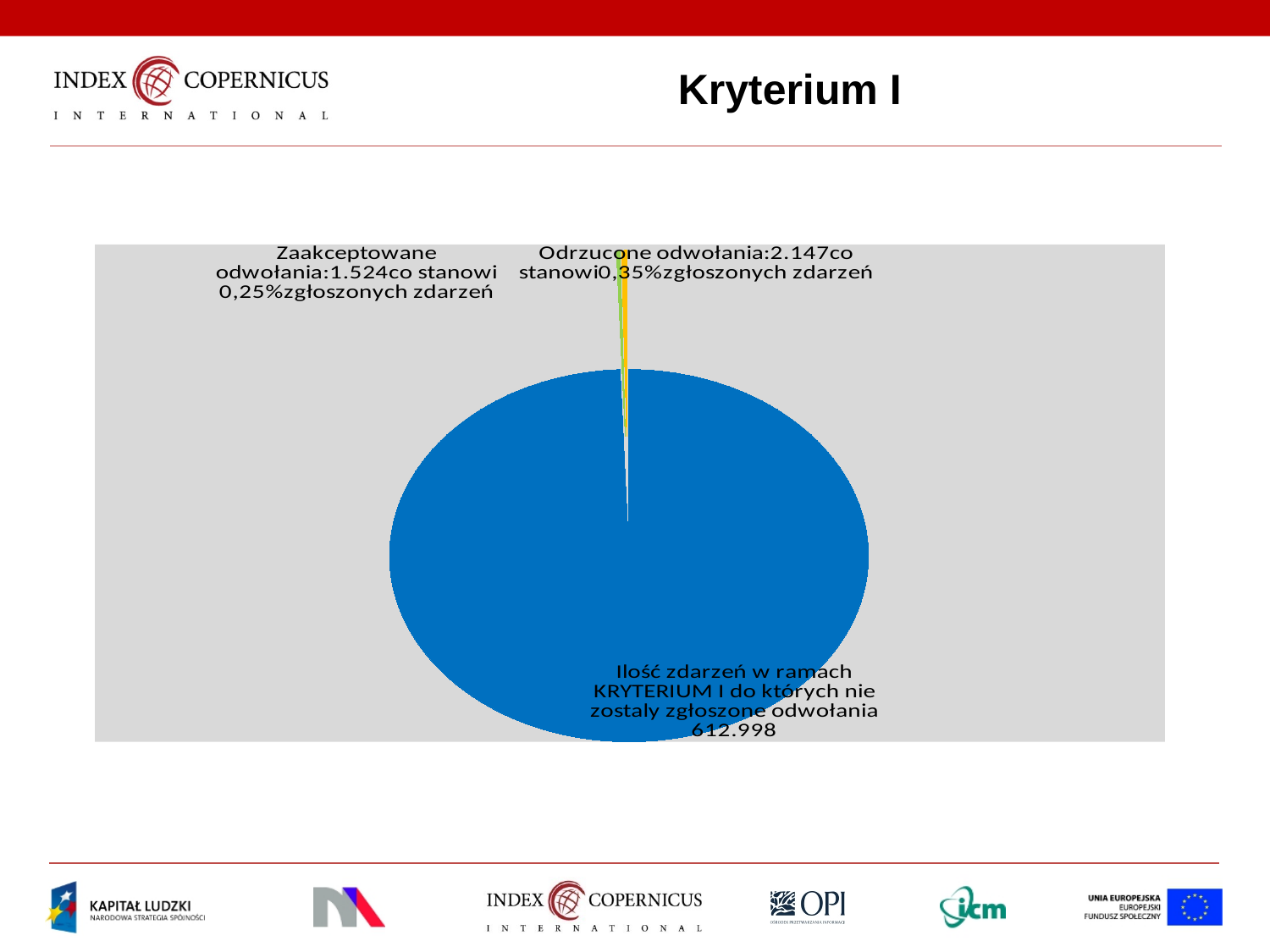
What is the title of the slide containing the pie chart? Kryterium I Which is larger: 'Odrzucone odwołania' or 'Zaakceptowane odwołania'? Odrzucone odwołania Which slice of the pie chart is the largest? Ilość zdarzeń w ramach KRYTERIUM I do których nie zostały zgłoszone odwołania What is the value for 'Odrzucone odwołania' in the pie chart? 2.147 What share of reported events do 'Odrzucone odwołania' represent according to the chart label? 0,35% What kind of chart is shown on the slide? pie chart What is the value for 'Zaakceptowane odwołania' in the pie chart? 1.524 What share of reported events do 'Zaakceptowane odwołania' represent according to the chart label? 0,25% How many slices does the pie chart have? 3 What is the value for 'Ilość zdarzeń w ramach KRYTERIUM I do których nie zostały zgłoszone odwołania'? 612.998 What is the difference between 'Odrzucone odwołania' (2.147) and 'Zaakceptowane odwołania' (1.524)? 623 Which slice of the pie chart is the smallest? Zaakceptowane odwołania